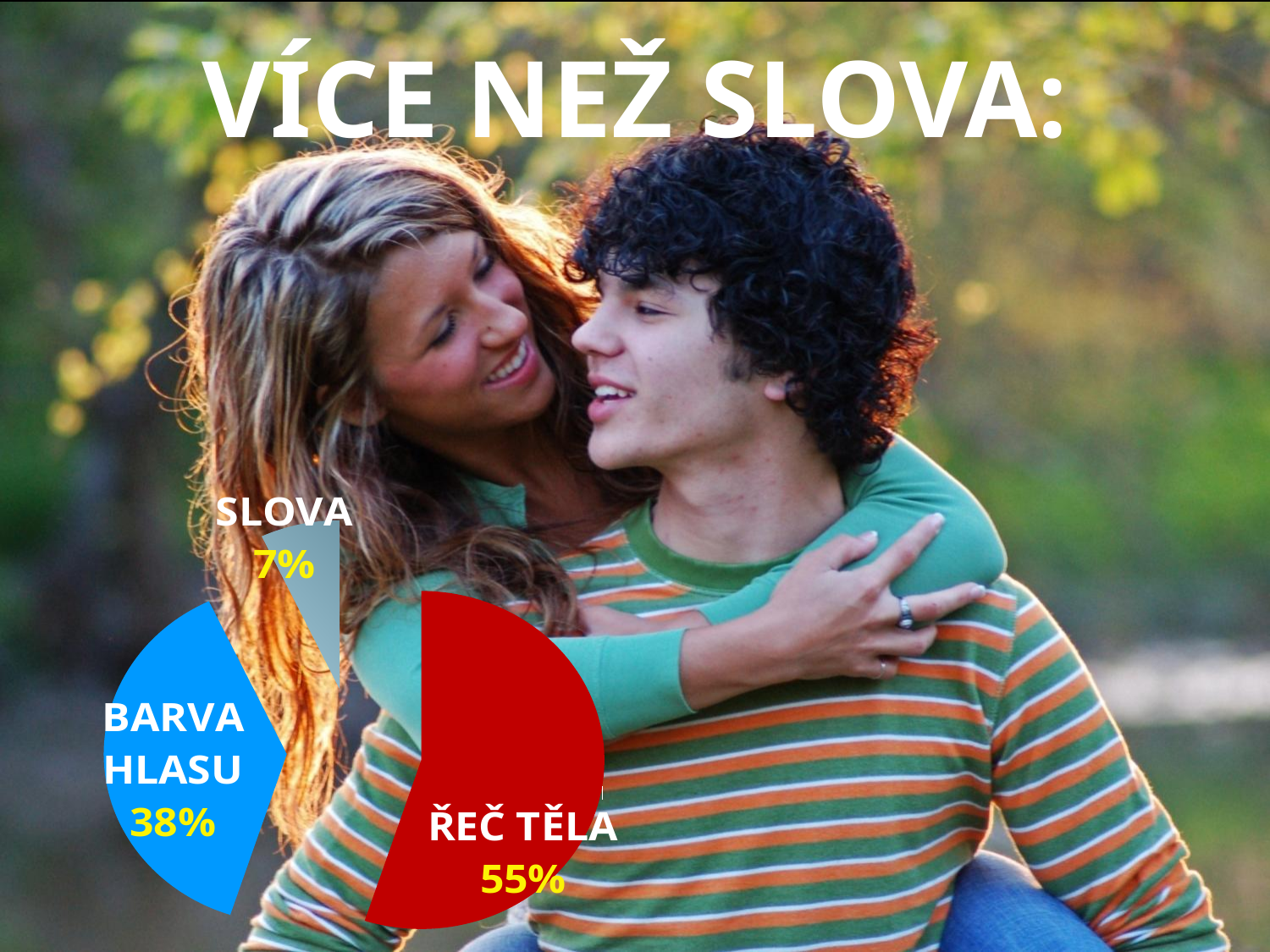
Which is larger, the share for BARVA HLASU or the share for SLOVA? BARVA HLASU What percentage is shown for BARVA HLASU? 38% How many slices does the pie chart have? 3 Which category has the largest share of the pie? ŘEČ TĚLA What is the title of the slide? VÍCE NEŽ SLOVA: What colour is the ŘEČ TĚLA slice? Red What is the difference between the shares of ŘEČ TĚLA and BARVA HLASU? 17% What is the difference between the shares of BARVA HLASU and SLOVA? 31% What kind of chart is shown on the slide? Pie chart What percentage is shown for SLOVA? 7% Which category has the smallest share of the pie? SLOVA What percentage is shown for ŘEČ TĚLA? 55%